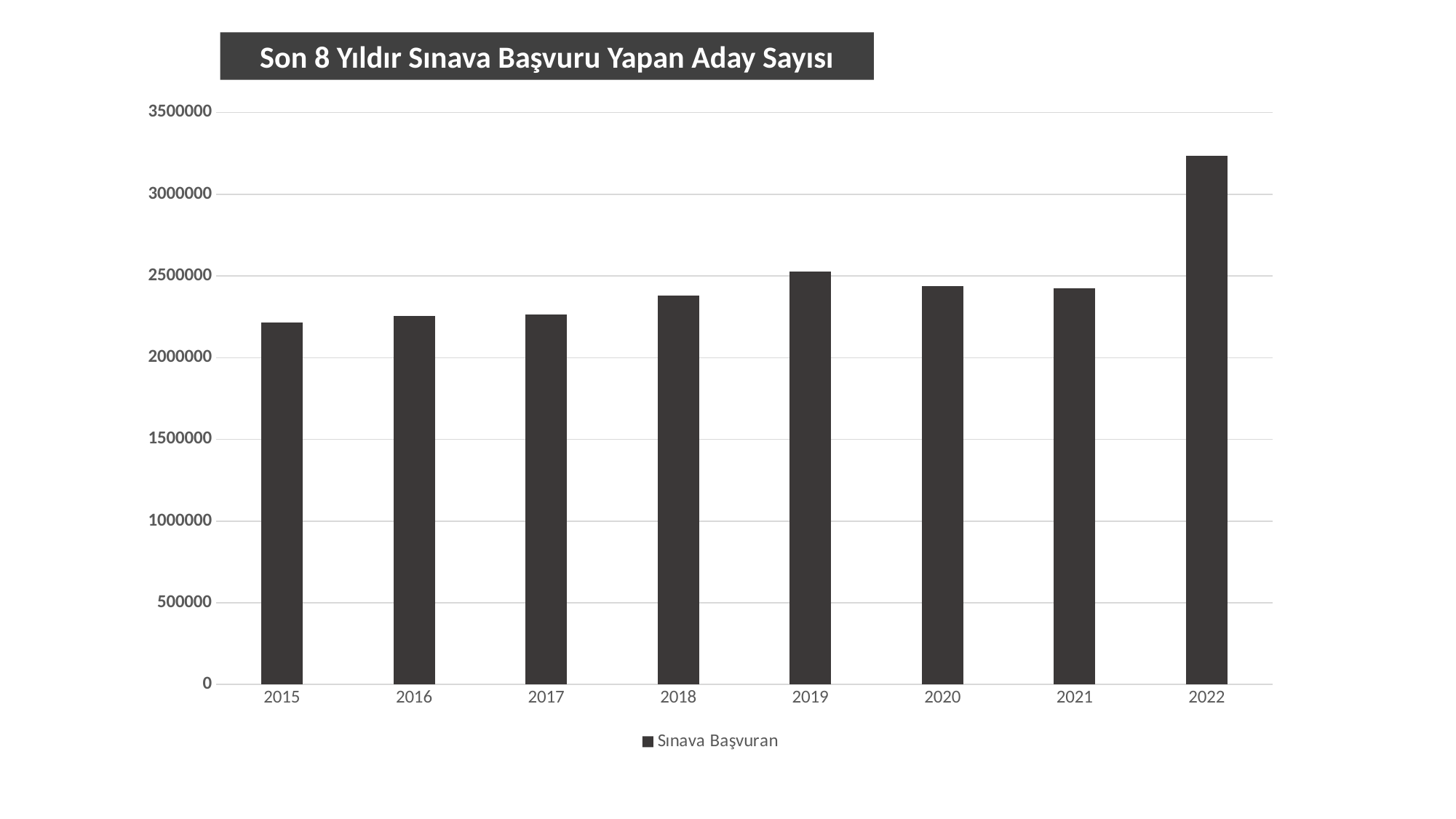
What kind of chart is shown on the slide? bar chart Does the value rise or fall from 2021 to 2022? rise Which is larger, the value for 2021 or the value for 2022? 2022 Which is larger, the value for 2019 or the value for 2018? 2019 How many series does the legend list? 1 What is the name of the series shown in the legend? Sınava Başvuran Is the value for 2018 greater or less than 2500000? less How many years are shown on the x axis? 8 Which year has the highest number of applicants? 2022 Is the value for 2022 greater or less than 3000000? greater Is the value for 2015 greater or less than 2000000? greater What is the title of the chart? Son 8 Yıldır Sınava Başvuru Yapan Aday Sayısı